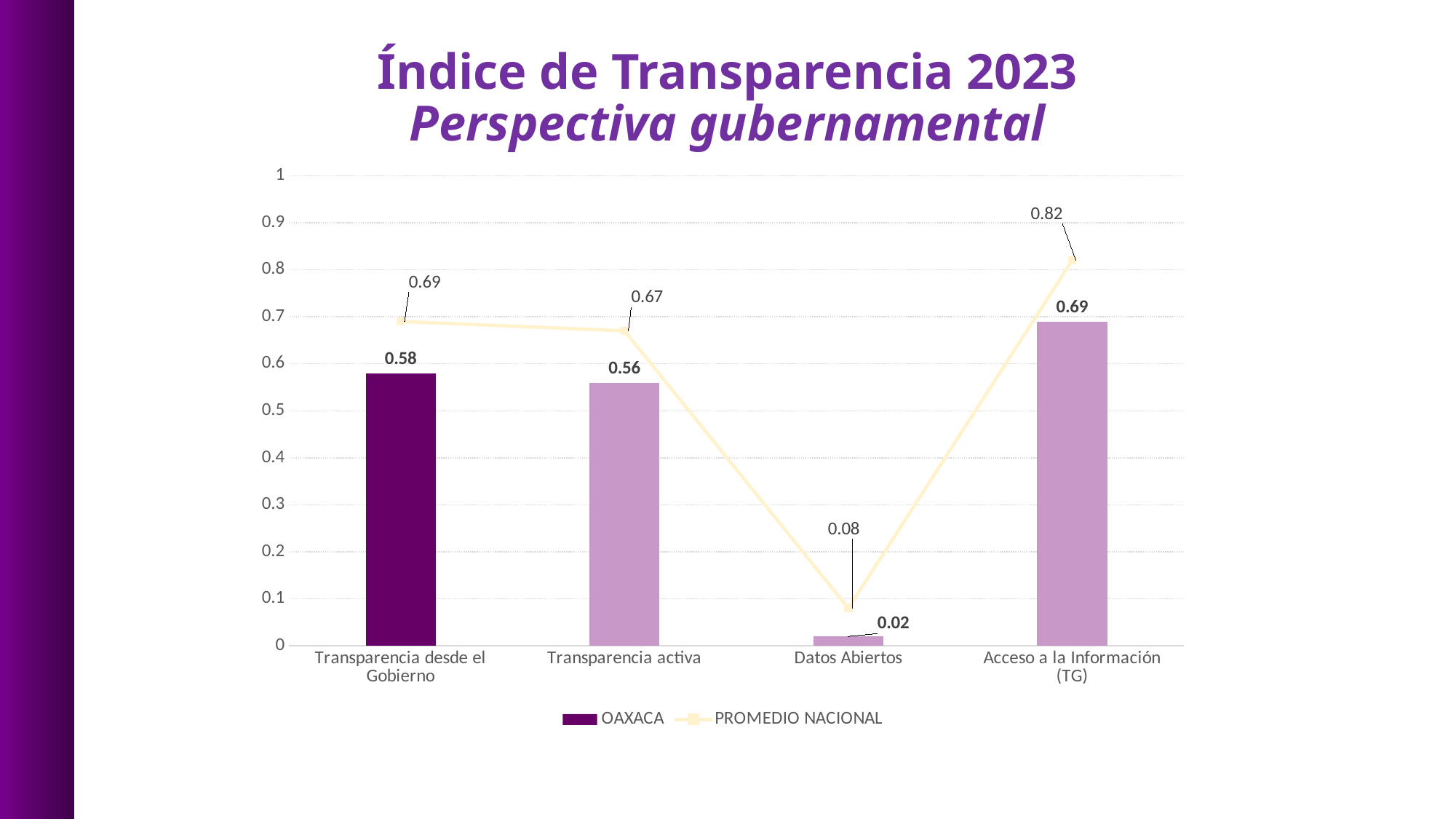
What is the OAXACA value for Acceso a la Información (TG)? 0.69 What is the difference between the PROMEDIO NACIONAL and OAXACA values for Acceso a la Información (TG)? 0.13 What is the title of the chart on the slide? Índice de Transparencia 2023 Perspectiva gubernamental Which category has the lowest PROMEDIO NACIONAL value? Datos Abiertos Which category has the highest OAXACA value? Acceso a la Información (TG) What kind of chart is used for the OAXACA series? Bar chart What is the PROMEDIO NACIONAL value for Transparencia activa? 0.67 Which is larger for Transparencia desde el Gobierno: the OAXACA value or the PROMEDIO NACIONAL value? PROMEDIO NACIONAL What is the OAXACA value for Transparencia desde el Gobierno? 0.58 How many categories are shown on the x axis? 4 What is the PROMEDIO NACIONAL value for Datos Abiertos? 0.08 How many series does the legend list? 2